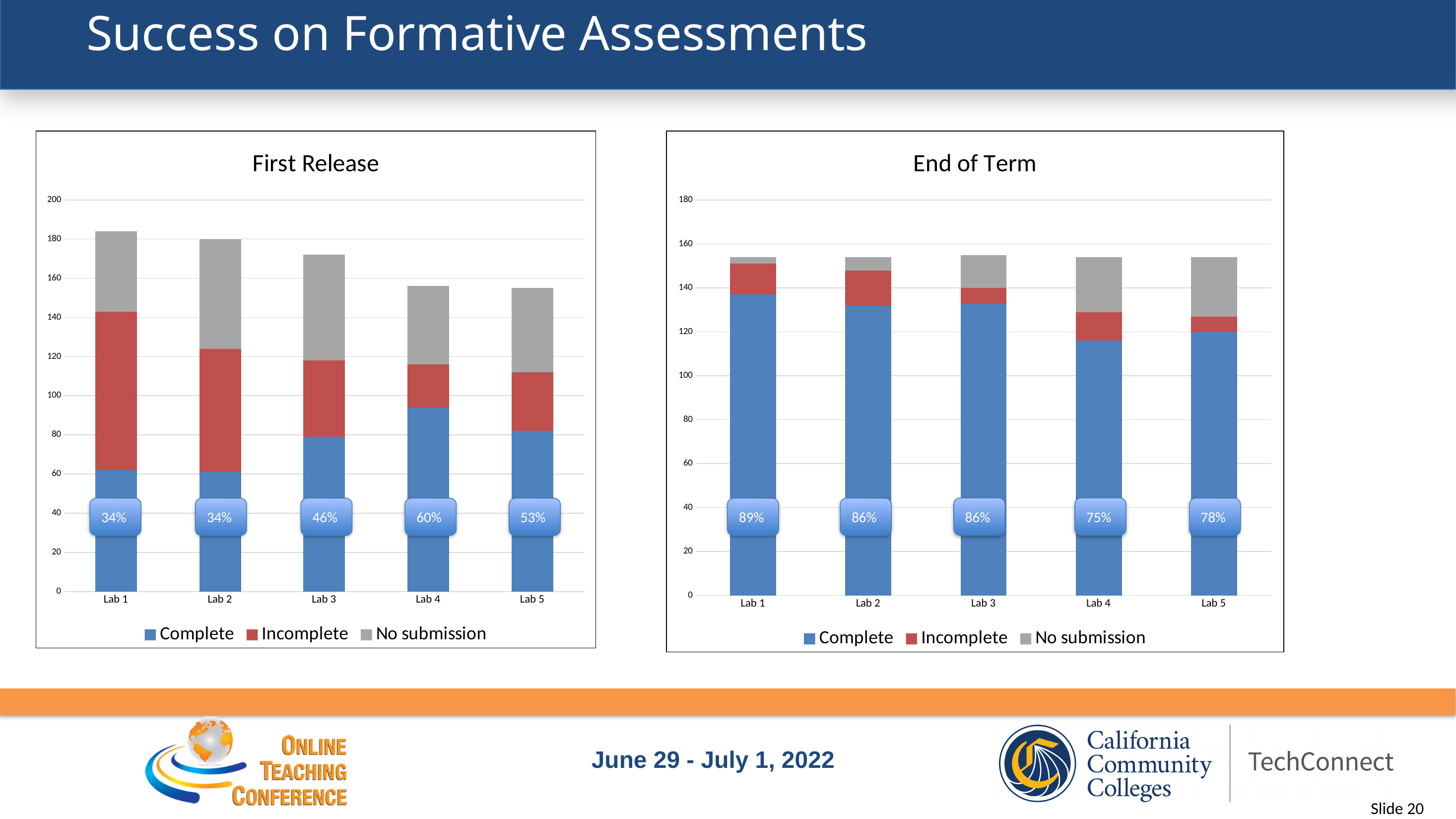
In the First Release chart, what is the difference between the percentage labels for Lab 4 and Lab 1? 26 percentage points In the First Release chart, is the total height of the Lab 1 stacked bar greater or less than 160? greater How many series does the legend of the End of Term chart list? 3 What type of chart is the End of Term chart? Stacked bar chart In the First Release chart, what percentage label is shown on the Lab 4 bar? 60% In the End of Term chart, is the Complete segment for Lab 1 greater or less than 120? greater How many labs are shown on the x axis of the First Release chart? 5 In the End of Term chart, which lab has the lowest percentage label? Lab 4 In the End of Term chart, which has the larger percentage label, Lab 4 or Lab 5? Lab 5 In the First Release chart, is the Complete segment for Lab 1 greater or less than 80? less In the First Release chart, which lab has the highest percentage label? Lab 4 In the End of Term chart, what percentage label is shown on the Lab 1 bar? 89%